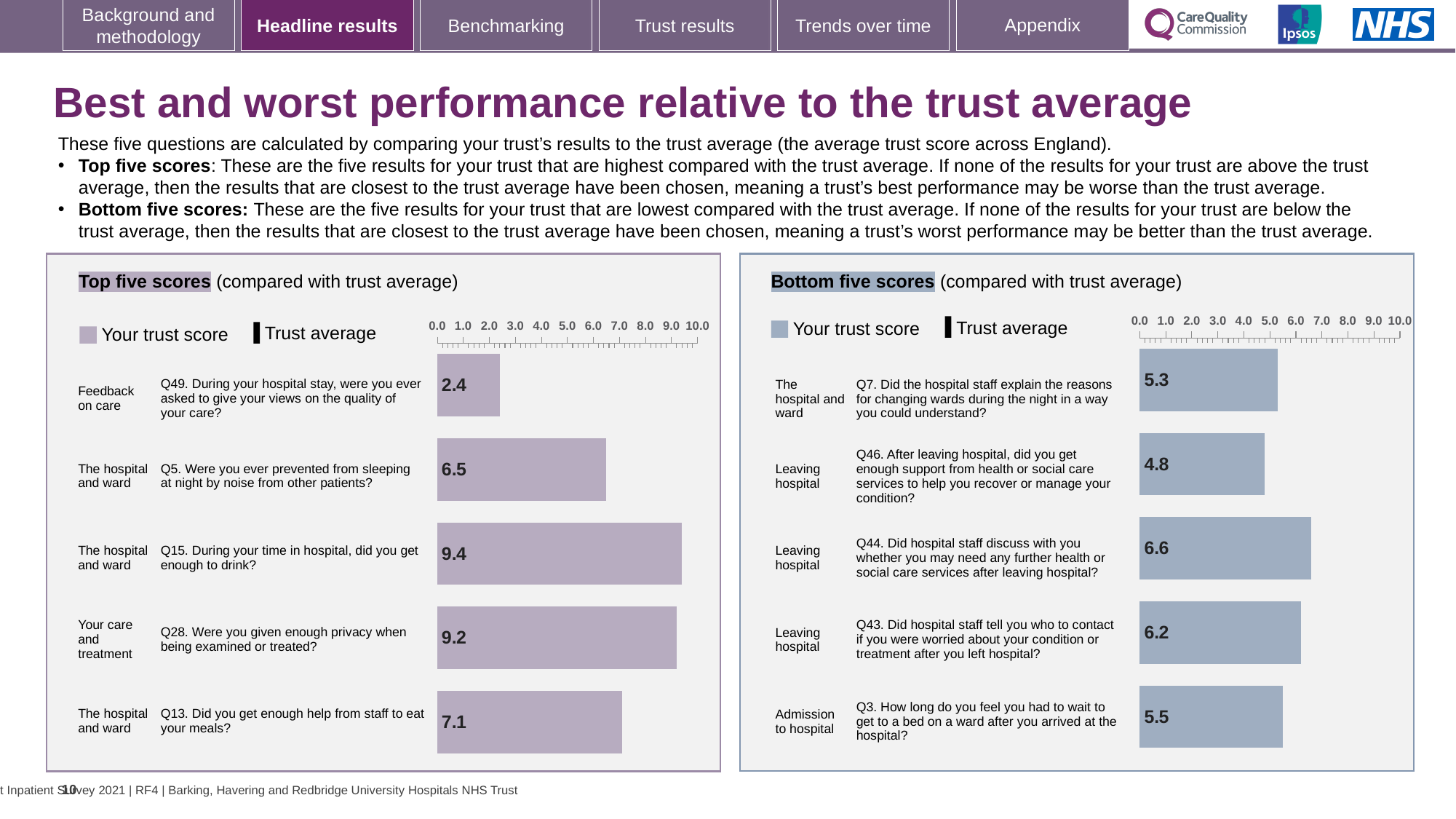
In the Top five scores chart, what is the trust score for Q15 (During your time in hospital, did you get enough to drink?)? 9.4 In the Top five scores chart, which question has the lowest trust score? Q49 In the Bottom five scores chart, which question has the lowest trust score? Q46 What type of chart is the Top five scores chart? bar chart In the Top five scores chart, is the score for Q13 greater or less than 6.0? greater In the Bottom five scores chart, which question has the highest trust score? Q44 In the Bottom five scores chart, what is the trust score for Q46 (After leaving hospital, did you get enough support from health or social care services)? 4.8 In the Top five scores chart, which question has the highest trust score? Q15 What two entries does the legend of the Top five scores chart list? Your trust score, Trust average In the Bottom five scores chart, which has the larger score: Q7 or Q3? Q3 In the Top five scores chart, what is the difference between the scores for Q15 and Q49? 7.0 How many bars are shown in the Bottom five scores chart? 5